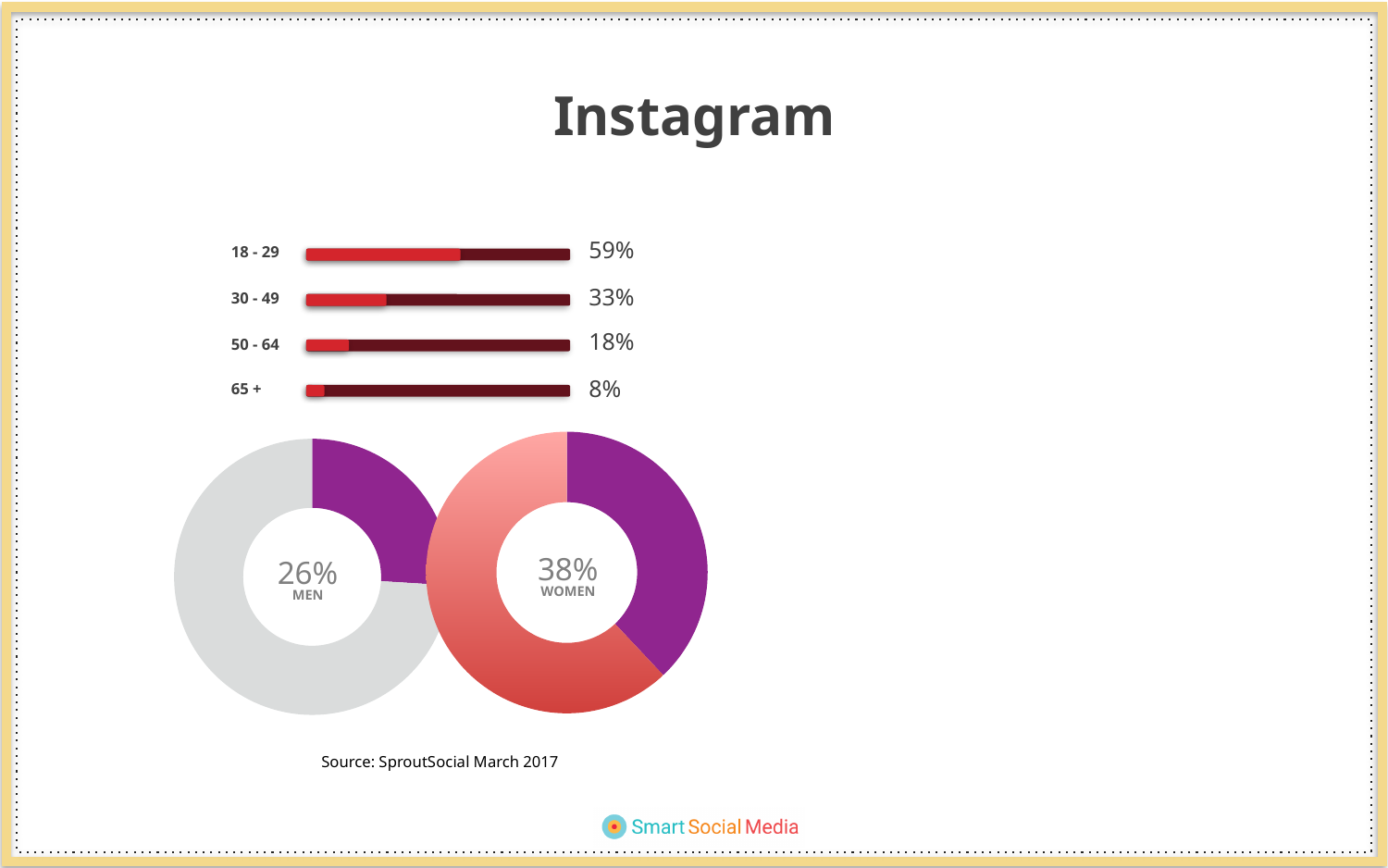
In the age-group bar chart, which age group has the highest value? 18 - 29 Comparing the two donut charts, which is larger, the percentage for men or for women? Women In the age-group bar chart, which age group has the lowest value? 65 + In the age-group bar chart, which is larger, the value for 50 - 64 or the value for 65 +? 50 - 64 In the age-group bar chart, what is the difference between the 18 - 29 and 30 - 49 values? 26% In the left donut chart, what percentage is shown for men? 26% In the age-group bar chart, what is the value for the 18 - 29 group? 59% In the age-group bar chart, what is the value for the 30 - 49 group? 33% In the age-group bar chart, what is the value for the 65 + group? 8% In the age-group bar chart, do the values rise or fall as the age groups get older? Fall What kind of chart is used to show the age groups at the top of the slide? Bar chart How many age groups are shown in the age-group bar chart? 4